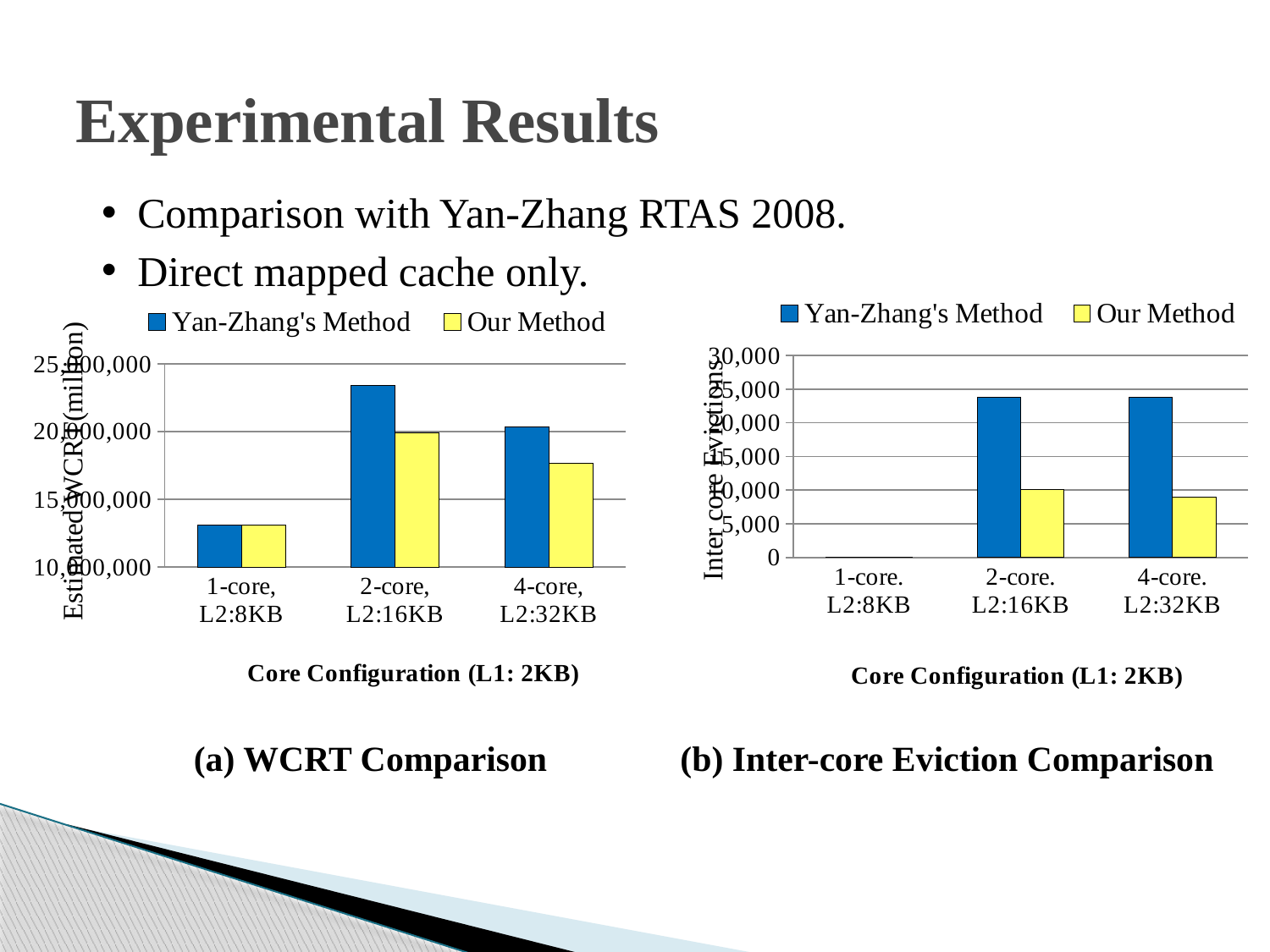
In the (a) WCRT Comparison chart, which core configuration has the highest value for Yan-Zhang's Method? 2-core, L2:16KB In the (a) WCRT Comparison chart, what kind of chart is shown? bar chart In the (a) WCRT Comparison chart, which is larger at 4-core, L2:32KB: Yan-Zhang's Method or Our Method? Yan-Zhang's Method In the (b) Inter-core Eviction Comparison chart, how many series does the legend list? 2 In the (a) WCRT Comparison chart, is the value for Our Method at 4-core, L2:32KB greater or less than 20,000,000? less In the (a) WCRT Comparison chart, how many core configurations are shown on the x axis? 3 In the (a) WCRT Comparison chart, is the value for Yan-Zhang's Method at 2-core, L2:16KB greater or less than 20,000,000? greater In the (a) WCRT Comparison chart, what is the x-axis title? Core Configuration (L1: 2KB) In the (b) Inter-core Eviction Comparison chart, which core configuration has the lowest value for Our Method? 1-core. L2:8KB In the (b) Inter-core Eviction Comparison chart, which is larger at 2-core. L2:16KB: Yan-Zhang's Method or Our Method? Yan-Zhang's Method In the (b) Inter-core Eviction Comparison chart, is the value for Our Method at 4-core. L2:32KB greater or less than 15,000? less